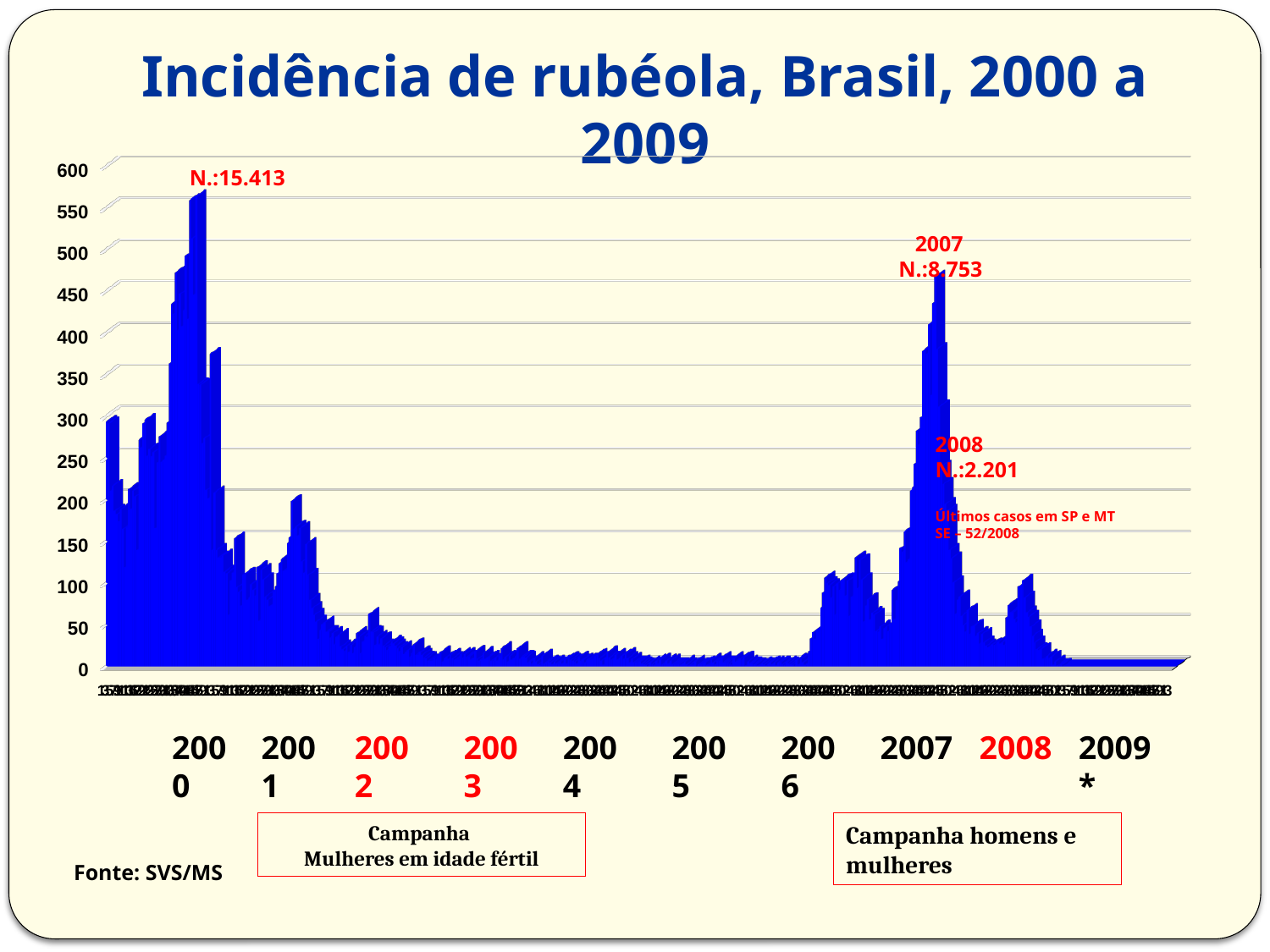
Which year has the highest peak of weekly cases? 2000 What total number of cases (N.) is annotated for 2007? 8.753 What kind of chart is shown on the slide? area chart What total number of cases (N.) is annotated for the 2000 peak? 15.413 Which peak is higher, the one in 2000 or the one in 2007? 2000 What total number of cases (N.) is annotated for 2008? 2.201 What is the title of the chart? Incidência de rubéola, Brasil, 2000 a 2009 How many year labels are shown along the x axis? 10 What is the highest value shown on the y axis? 600 Are the weekly values during 2004 greater or less than 50? less Is the highest weekly value in 2000 greater or less than 500? greater Is the highest weekly value in 2007 greater or less than 400? greater